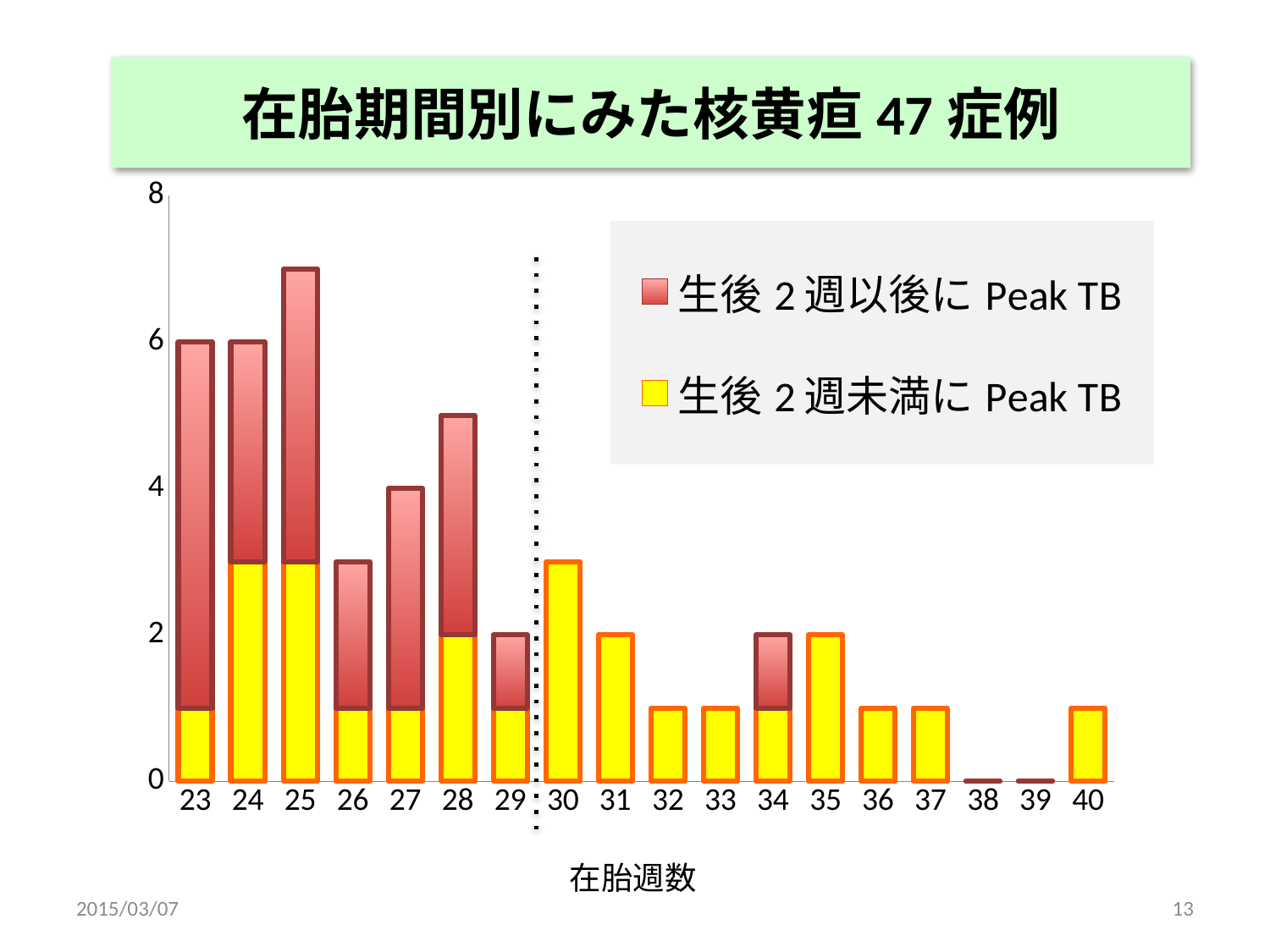
Is the total value for gestational week 25 greater or less than 6? greater What is the difference between the total cases at week 23 and at week 27? 2 How many gestational-week categories are shown on the x axis? 18 What is the x-axis title of the chart? 在胎週数 How many series does the legend list? 2 Which has more total cases, gestational week 24 or gestational week 29? 24 What kind of chart is shown on the slide? bar chart What is the value of 生後 2 週未満に Peak TB at gestational week 28? 2 Do the total case counts generally rise or fall from week 23 to week 40? fall What is the total number of cases at gestational week 23? 6 Which gestational week has the highest total number of cases? 25 What is the total number of cases at gestational week 27? 4